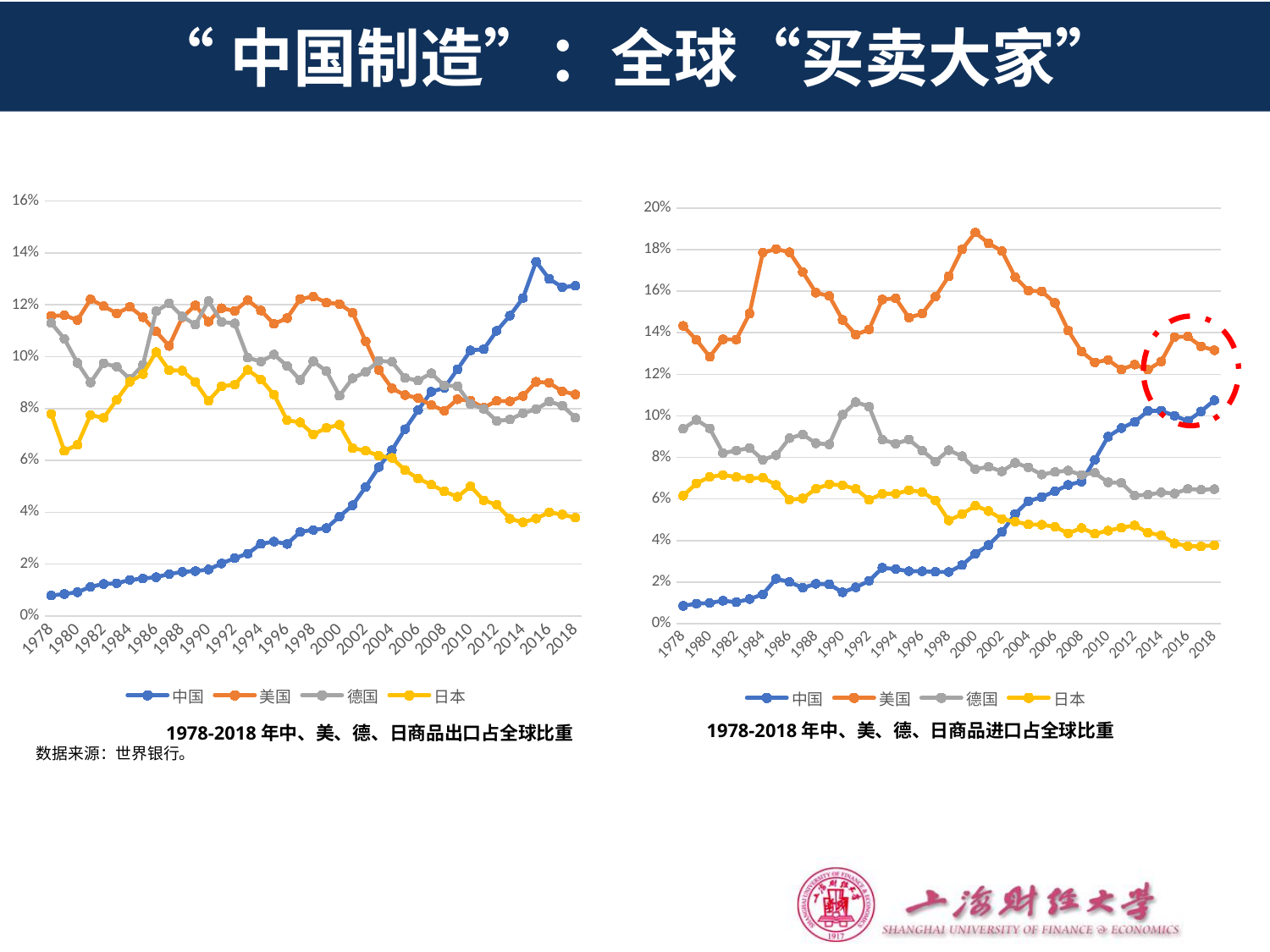
In the right chart (商品进口占全球比重), which is larger in 2018, the value for 德国 or the value for 日本? 德国 In the left chart (商品出口占全球比重), which series has the lowest value in 2018? 日本 In the left chart (商品出口占全球比重), which series has the highest value in 2018? 中国 In the left chart (商品出口占全球比重), is the value for 中国 in 1978 greater or less than 2%? less In the left chart (商品出口占全球比重), does the 日本 series generally rise or fall from 1994 to 2018? fall In the right chart (商品进口占全球比重), is the value for 中国 in 2018 greater or less than 10%? greater What kind of chart is the left chart titled "1978-2018 年中、美、德、日商品出口占全球比重"? line chart What colour is the 中国 series in both charts? blue In the left chart (商品出口占全球比重), is the value for 中国 in 2018 greater or less than 12%? greater How many series does the legend of the right chart (商品进口占全球比重) list? 4 In the right chart (商品进口占全球比重), which series has the highest value in 2018? 美国